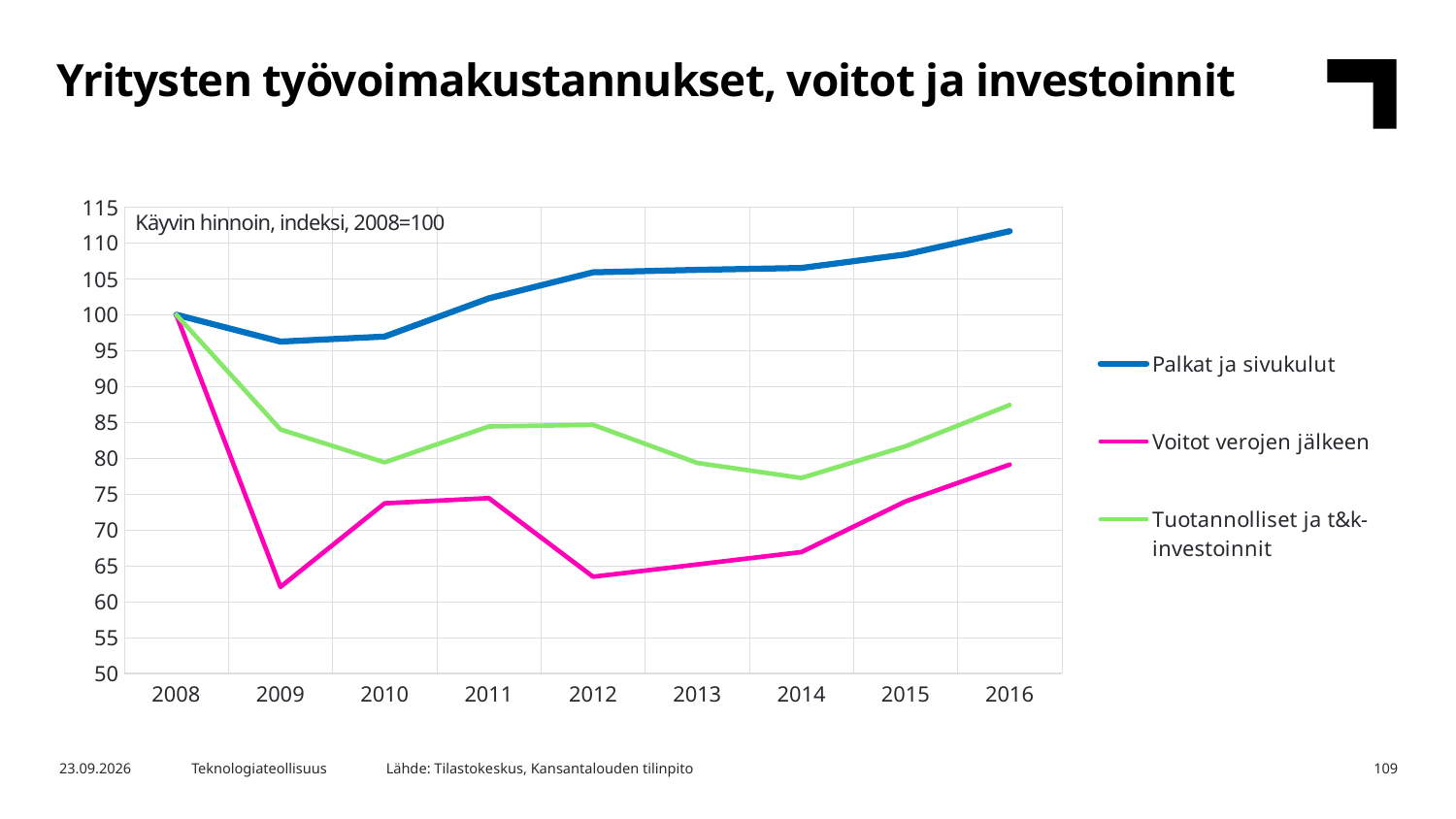
Is the value for Palkat ja sivukulut in 2016 greater or less than 110? greater Does the Palkat ja sivukulut series rise or fall from 2010 to 2016? rise Is the value for Voitot verojen jälkeen in 2009 greater or less than 65? less How many years are shown on the x axis? 9 How many series does the legend list? 3 In 2012, which is larger: Tuotannolliset ja t&k-investoinnit or Voitot verojen jälkeen? Tuotannolliset ja t&k-investoinnit Which series has the lowest value in 2009? Voitot verojen jälkeen What is the value of Palkat ja sivukulut in 2008? 100 Is the value for Tuotannolliset ja t&k-investoinnit in 2014 greater or less than 80? less What kind of chart is shown on the slide? line chart What is the index base year stated in the chart's subtitle? 2008=100 Which series has the highest value in 2016? Palkat ja sivukulut